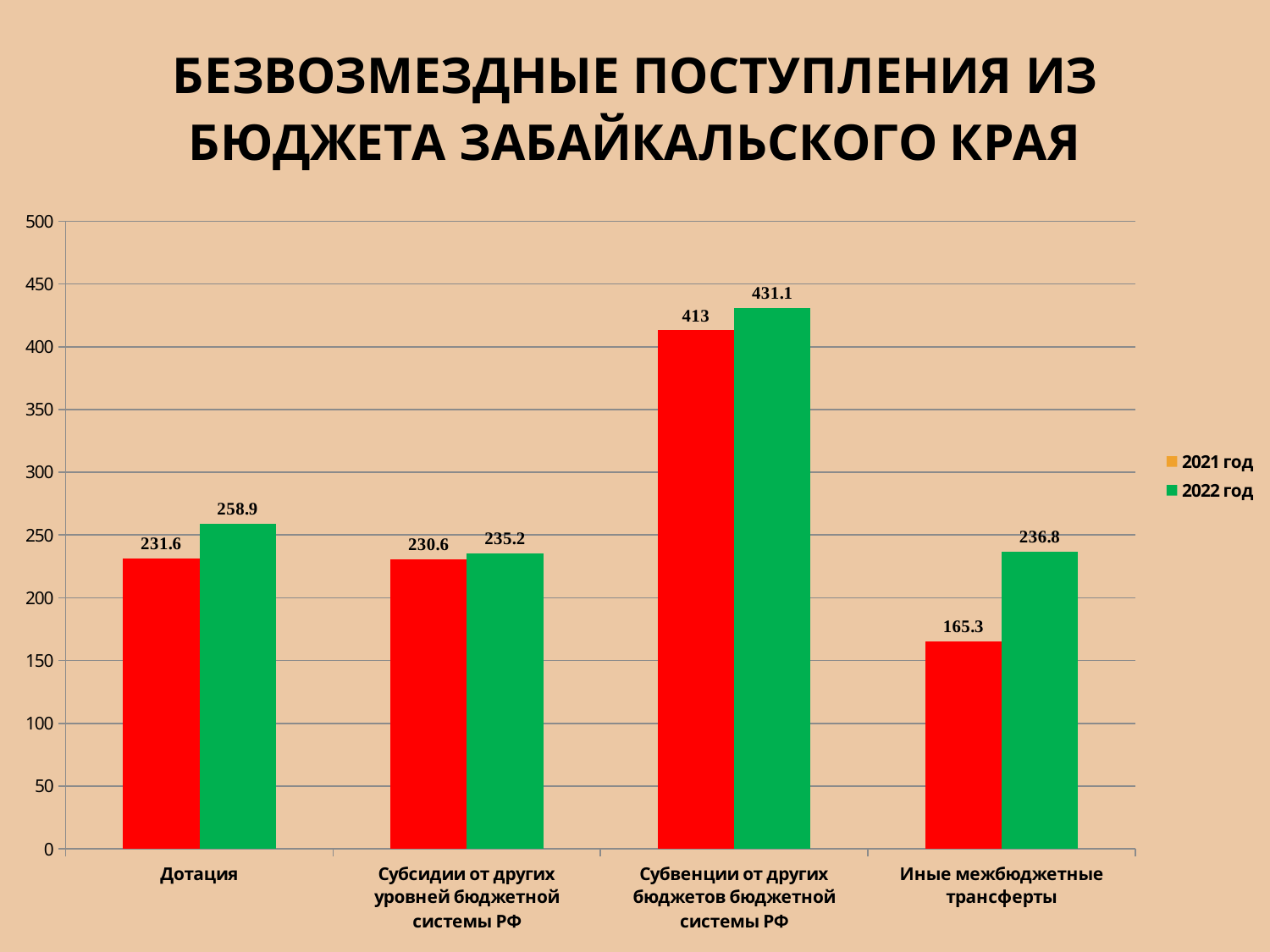
What is the difference between the 2022 год and 2021 год values for Субвенции от других бюджетов бюджетной системы РФ? 18.1 Which is larger for Дотация: the 2021 год value or the 2022 год value? 2022 год What is the difference between the 2022 год and 2021 год values for Иные межбюджетные трансферты? 71.5 How many categories are shown on the x axis? 4 Is the 2021 год value for Субсидии от других уровней бюджетной системы РФ greater or less than 250? less Which category has the lowest value in the 2021 год series? Иные межбюджетные трансферты What is the value for Дотация in the 2022 год series? 258.9 Which category has the highest value in the 2022 год series? Субвенции от других бюджетов бюджетной системы РФ How many series does the legend list? 2 What is the value for Субвенции от других бюджетов бюджетной системы РФ in the 2021 год series? 413 What is the value for Иные межбюджетные трансферты in the 2021 год series? 165.3 What kind of chart is shown on the slide? bar chart